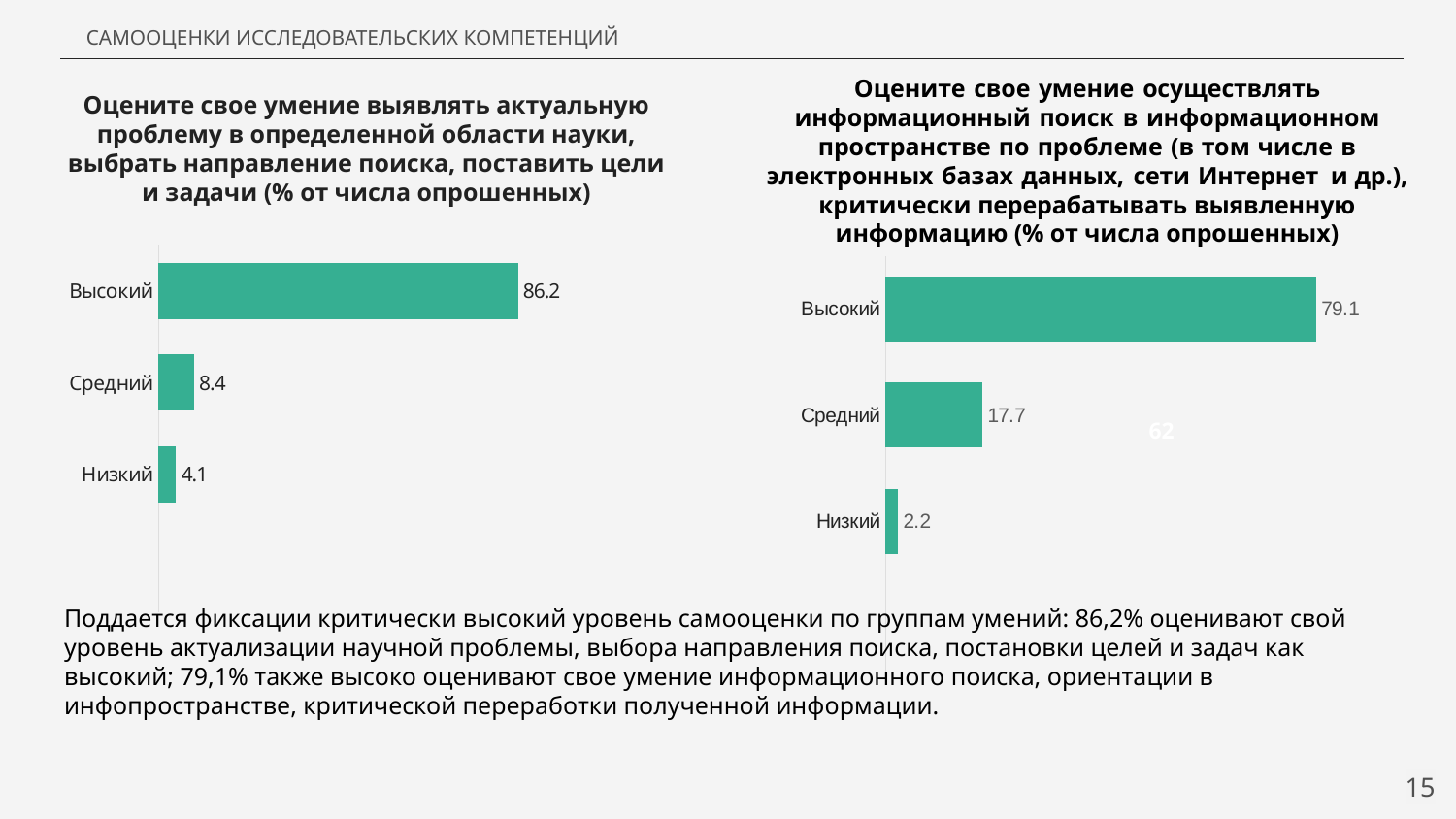
In the right chart, what is the value for Высокий? 79.1 In the left chart, what is the difference between the values for Средний and Низкий? 4.3 In the right chart, what is the difference between the values for Высокий and Средний? 61.4 In the right chart, which category has the highest value? Высокий In the left chart, which category has the lowest value? Низкий In the left chart, what is the value for Высокий? 86.2 In the left chart, what is the value for Средний? 8.4 In the left chart, do the values rise or fall going from Высокий to Низкий? Fall In the right chart, what is the value for Низкий? 2.2 How many categories are shown in the left chart? 3 Which is larger: the value for Средний in the left chart or the value for Средний in the right chart? Средний in the right chart What type of chart is the right chart? Bar chart